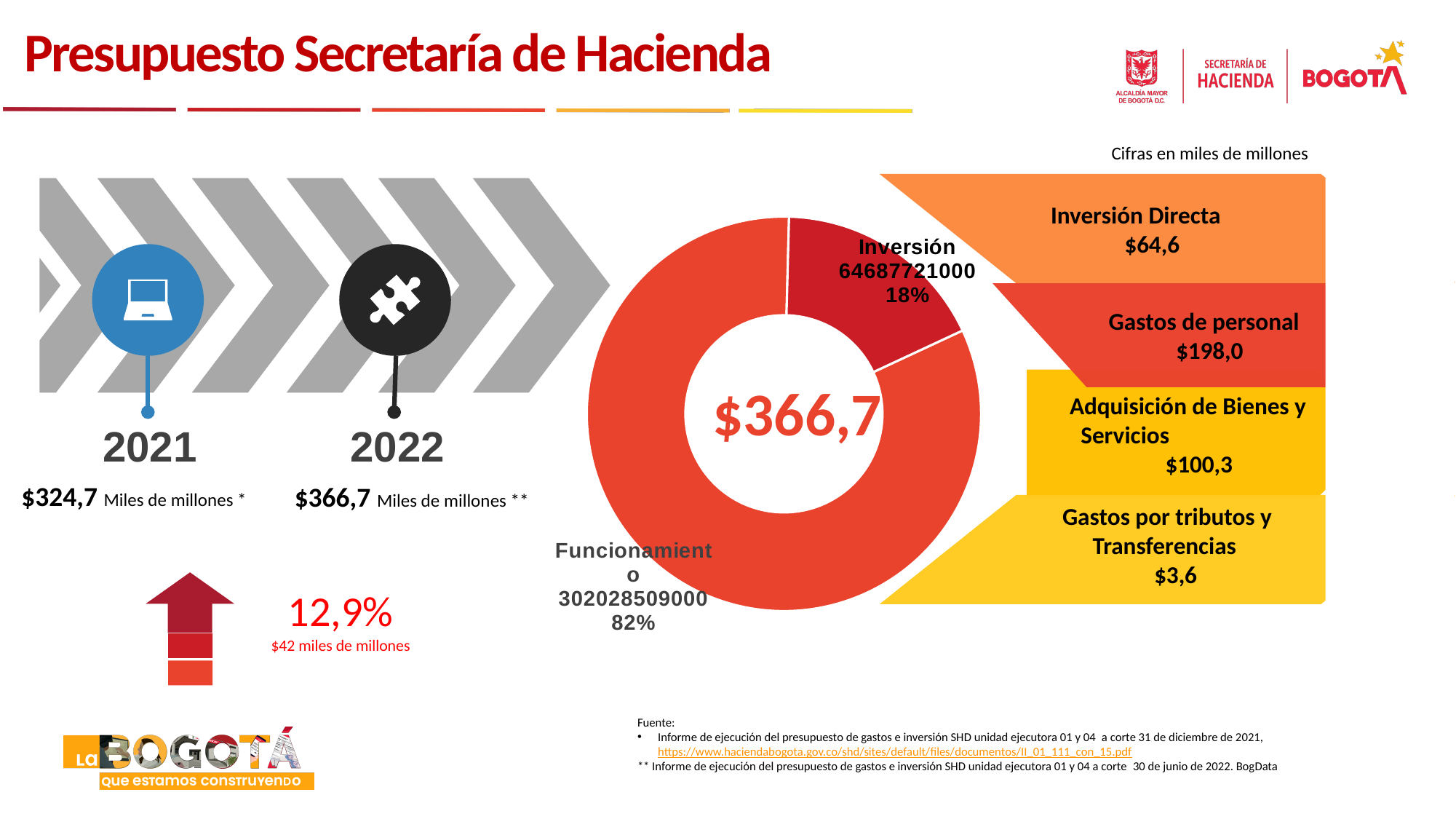
Which slice of the doughnut chart is the smallest? Inversión In the doughnut chart, what value is shown for Funcionamiento? 302028509000 What is the difference between the Funcionamiento value and the Inversión value in the doughnut chart? 237340788000 What percentage share of the doughnut chart does Funcionamiento represent? 82% What value is printed in the centre of the doughnut chart? $366,7 Which is larger in the doughnut chart, Funcionamiento or Inversión? Funcionamiento In the doughnut chart, what value is shown for Inversión? 64687721000 What is the sum of the two values shown in the doughnut chart? 366716230000 What percentage share of the doughnut chart does Inversión represent? 18% What kind of chart is shown in the middle of the slide? doughnut chart Which slice of the doughnut chart is the largest? Funcionamiento How many slices does the doughnut chart have? 2